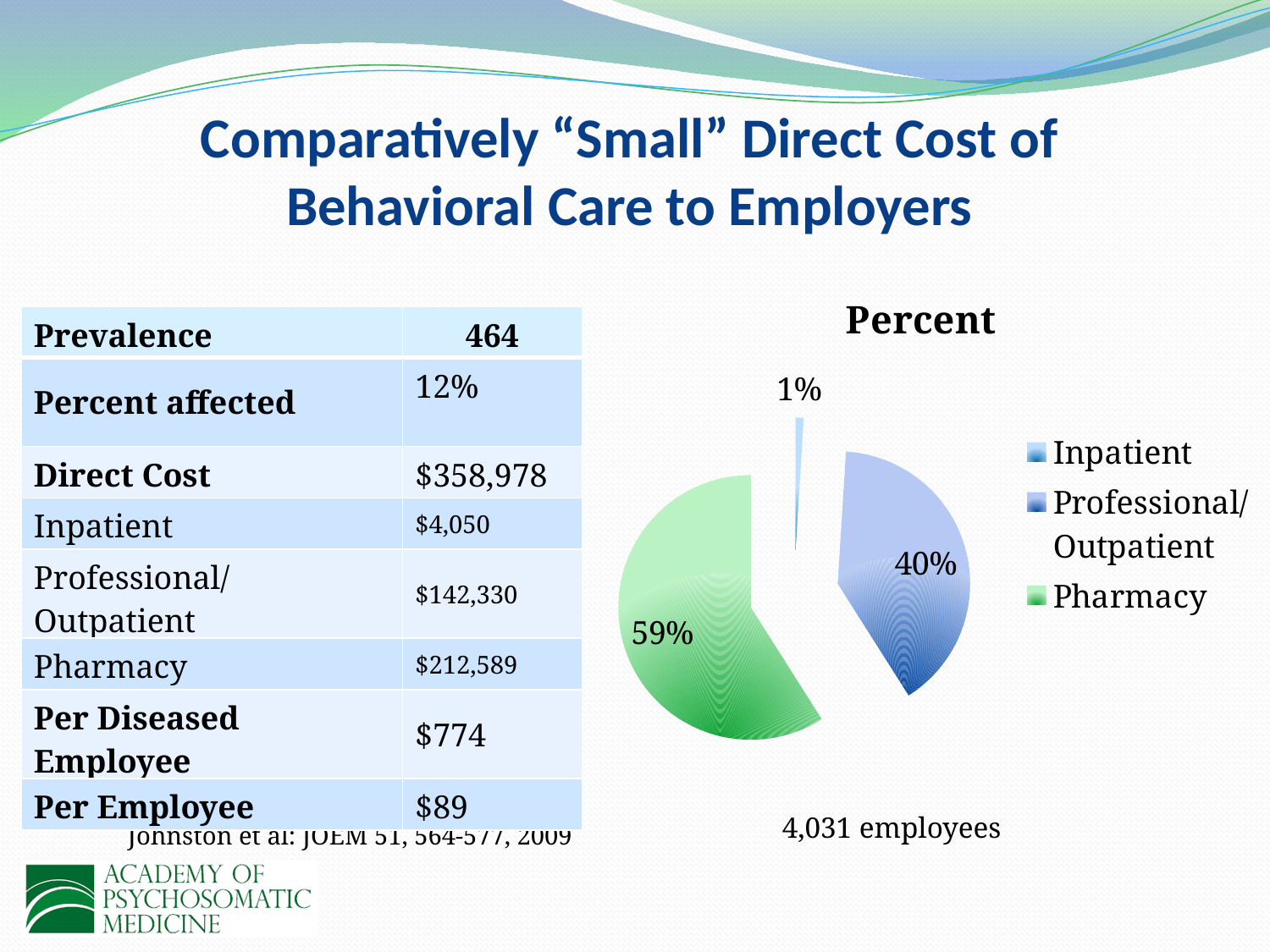
Which legend entry in the pie chart is shown in green? Pharmacy Which category has the largest slice in the pie chart? Pharmacy What kind of chart is shown on the slide? pie chart How many entries does the pie chart's legend list? 3 What percentage does the Pharmacy slice show in the pie chart? 59% In the pie chart, which is larger: the Pharmacy slice or the Professional/Outpatient slice? Pharmacy What percentage does the Professional/Outpatient slice show in the pie chart? 40% What is the title of the pie chart? Percent What percentage does the Inpatient slice show in the pie chart? 1% What is the difference in percentage points between the Pharmacy slice and the Professional/Outpatient slice in the pie chart? 19 How many slices does the pie chart have? 3 Which category has the smallest slice in the pie chart? Inpatient